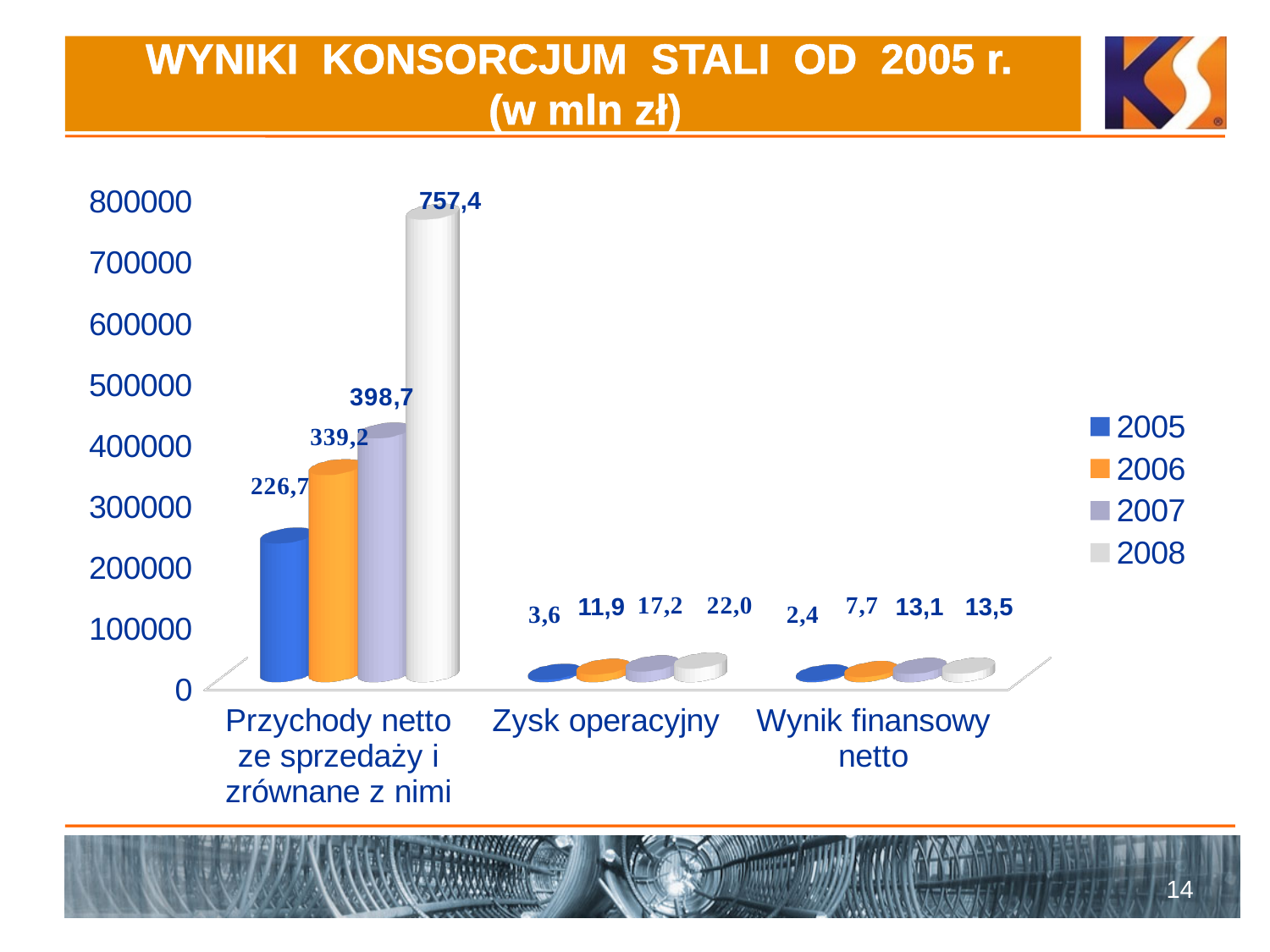
Which is larger in the 'Zysk operacyjny' category: the value for 2006 or the value for 2007? 2007 What is the difference between the 2008 and 2005 values in the 'Zysk operacyjny' category? 18,4 Which year has the highest value in the 'Przychody netto ze sprzedaży i zrównane z nimi' category? 2008 How many categories are shown on the x axis? 3 What is the value for 2005 in the 'Zysk operacyjny' category? 3,6 Which year has the lowest value in the 'Wynik finansowy netto' category? 2005 What is the value for 2008 in the 'Przychody netto ze sprzedaży i zrównane z nimi' category? 757,4 What is the value for 2007 in the 'Wynik finansowy netto' category? 13,1 What kind of chart is shown on the slide? Bar chart How many series does the legend list? 4 What is the value for 2006 in the 'Przychody netto ze sprzedaży i zrównane z nimi' category? 339,2 What is the difference between the 2008 and 2007 values in the 'Przychody netto ze sprzedaży i zrównane z nimi' category? 358,7